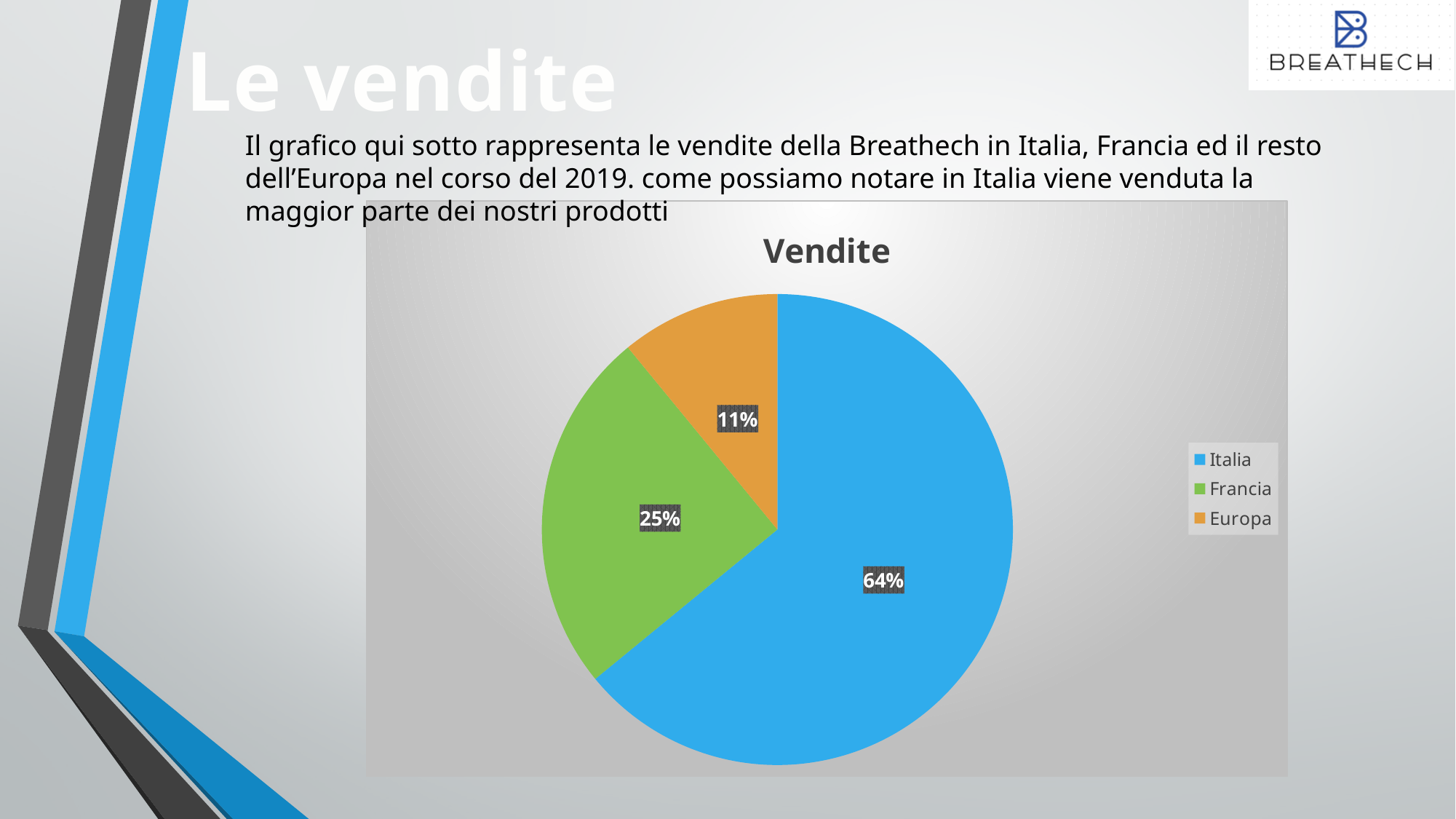
What is the title of the chart? Vendite Which category has the largest slice of the pie? Italia What share of sales does Europa account for? 11% What share of sales does Italia account for? 64% Which colour represents Europa in the legend? orange What type of chart is shown on the slide? pie chart What share of sales does Francia account for? 25% Which is larger, the share for Francia or the share for Europa? Francia Which category has the smallest slice of the pie? Europa What is the difference in percentage points between Italia and Francia? 39 How many slices does the pie chart have? 3 What is the difference in percentage points between Francia and Europa? 14